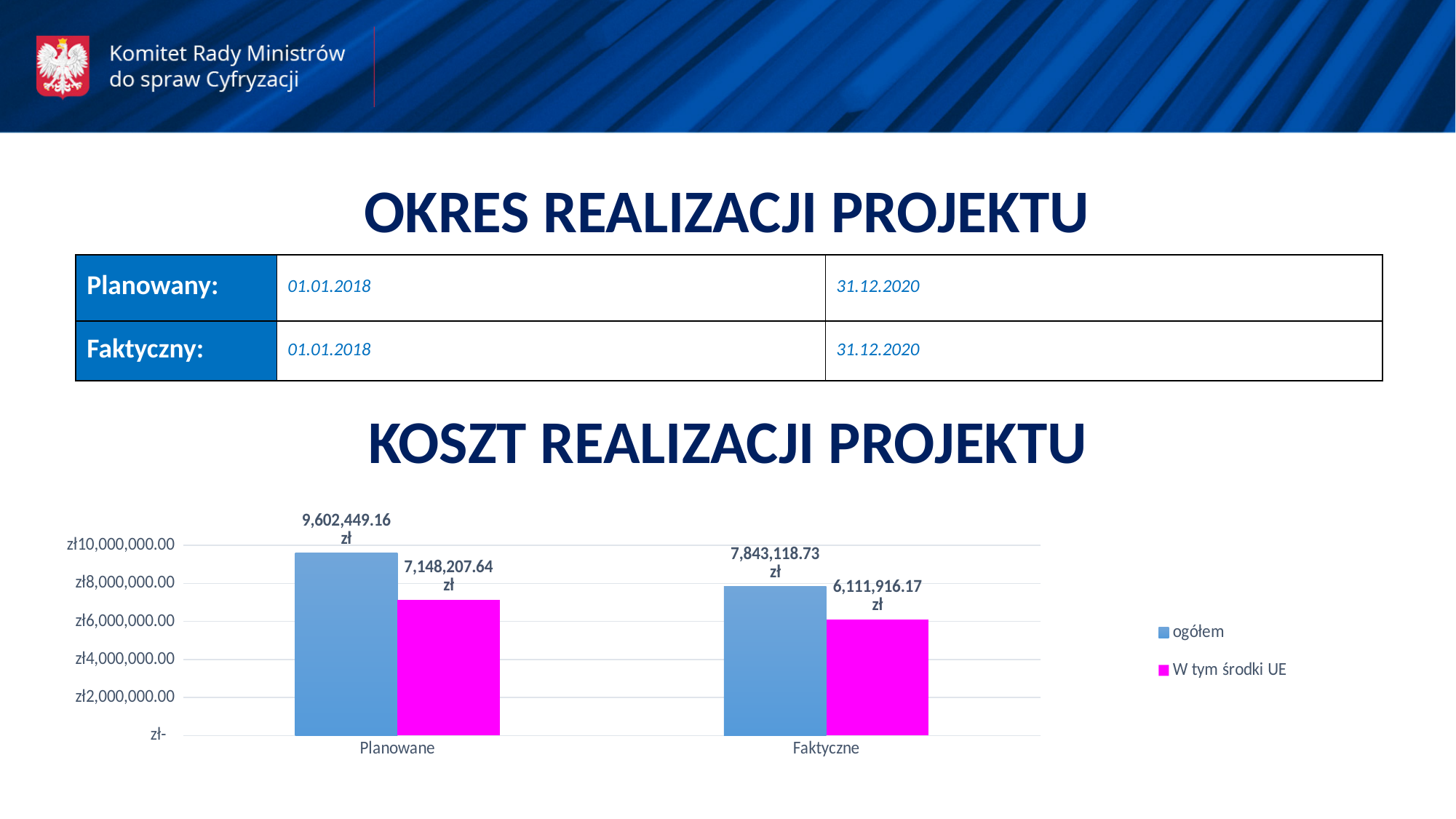
What is the value of the 'ogółem' bar for 'Planowane'? 9,602,449.16 zł What is the value of the 'ogółem' bar for 'Faktyczne'? 7,843,118.73 zł Which bar in the chart has the highest value? ogółem for Planowane What is the difference between the 'ogółem' values for 'Planowane' and 'Faktyczne'? 1,759,330.43 zł What is the difference between the 'ogółem' and 'W tym środki UE' values for 'Faktyczne'? 1,731,202.56 zł Is the 'ogółem' value for 'Planowane' larger or smaller than the 'ogółem' value for 'Faktyczne'? larger Which bar in the chart has the lowest value? W tym środki UE for Faktyczne What is the value of the 'W tym środki UE' bar for 'Faktyczne'? 6,111,916.17 zł What is the value of the 'W tym środki UE' bar for 'Planowane'? 7,148,207.64 zł What type of chart is shown under 'KOSZT REALIZACJI PROJEKTU'? bar chart How many series does the chart legend list? 2 How many categories are shown on the x axis of the chart? 2